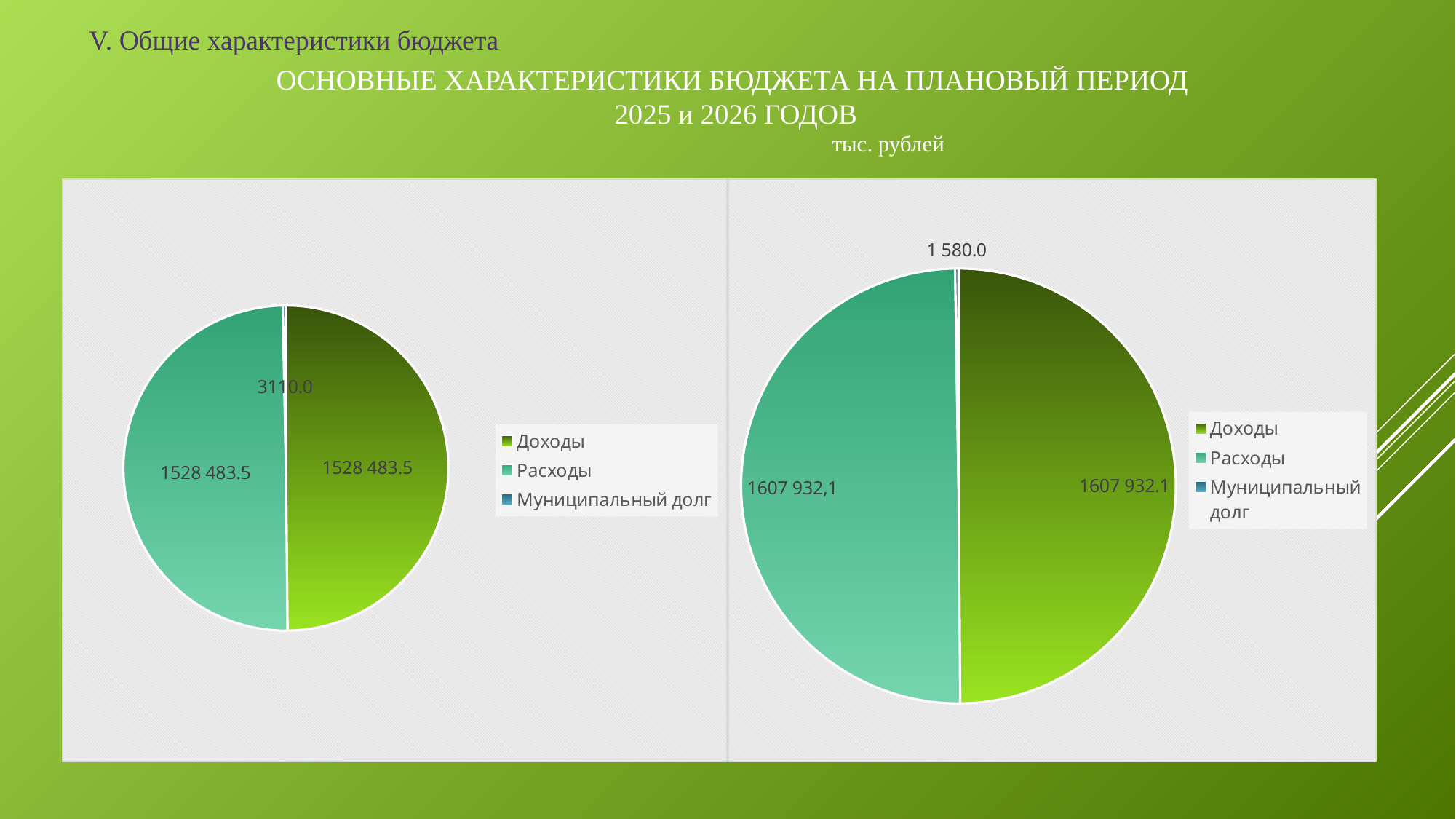
What kind of chart is the left chart on the slide? Pie chart In the right pie chart, what is the value for Расходы? 1607 932,1 In the right pie chart, what is the value for Доходы? 1607 932.1 In the right pie chart, what is the value for Муниципальный долг? 1 580.0 In the left pie chart, what is the difference between Доходы and Муниципальный долг? 1525 373.5 In the right pie chart, which is larger: Доходы or Муниципальный долг? Доходы How many slices does the left pie chart have? 3 How many entries does the legend of the right pie chart list? 3 In the left pie chart, which category has the smallest value? Муниципальный долг In the left pie chart, what is the value for Муниципальный долг? 3110.0 In the right pie chart, what is the difference between Доходы and Муниципальный долг? 1606 352.1 In the left pie chart, what is the value for Доходы? 1528 483.5